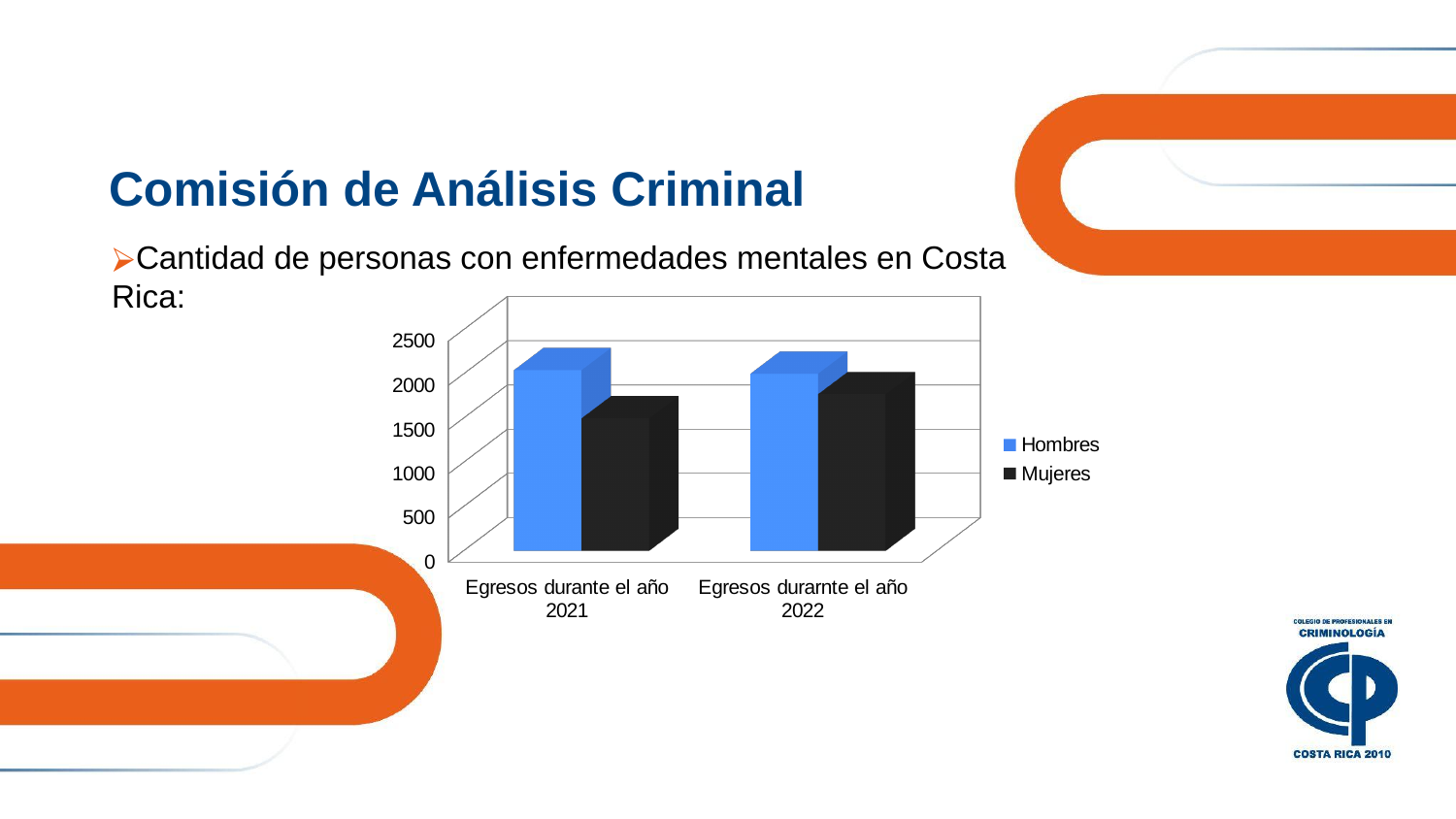
In 'Egresos durante el año 2021', which is larger, Hombres or Mujeres? Hombres Which colour represents Hombres in the chart? Blue Is the value for Mujeres in 'Egresos durante el año 2021' greater or less than 2000? less Is the value for Hombres in 'Egresos durante el año 2021' greater or less than 1500? greater How many categories are shown on the x axis? 2 What are the two series named in the legend? Hombres and Mujeres What kind of chart is shown on the slide? Bar chart For Mujeres, which is larger, the 2021 value or the 2022 value? 2022 Is the value for Mujeres in 'Egresos durarnte el año 2022' greater or less than 2500? less Which bar is the lowest in the chart? Mujeres, Egresos durante el año 2021 How many series does the legend list? 2